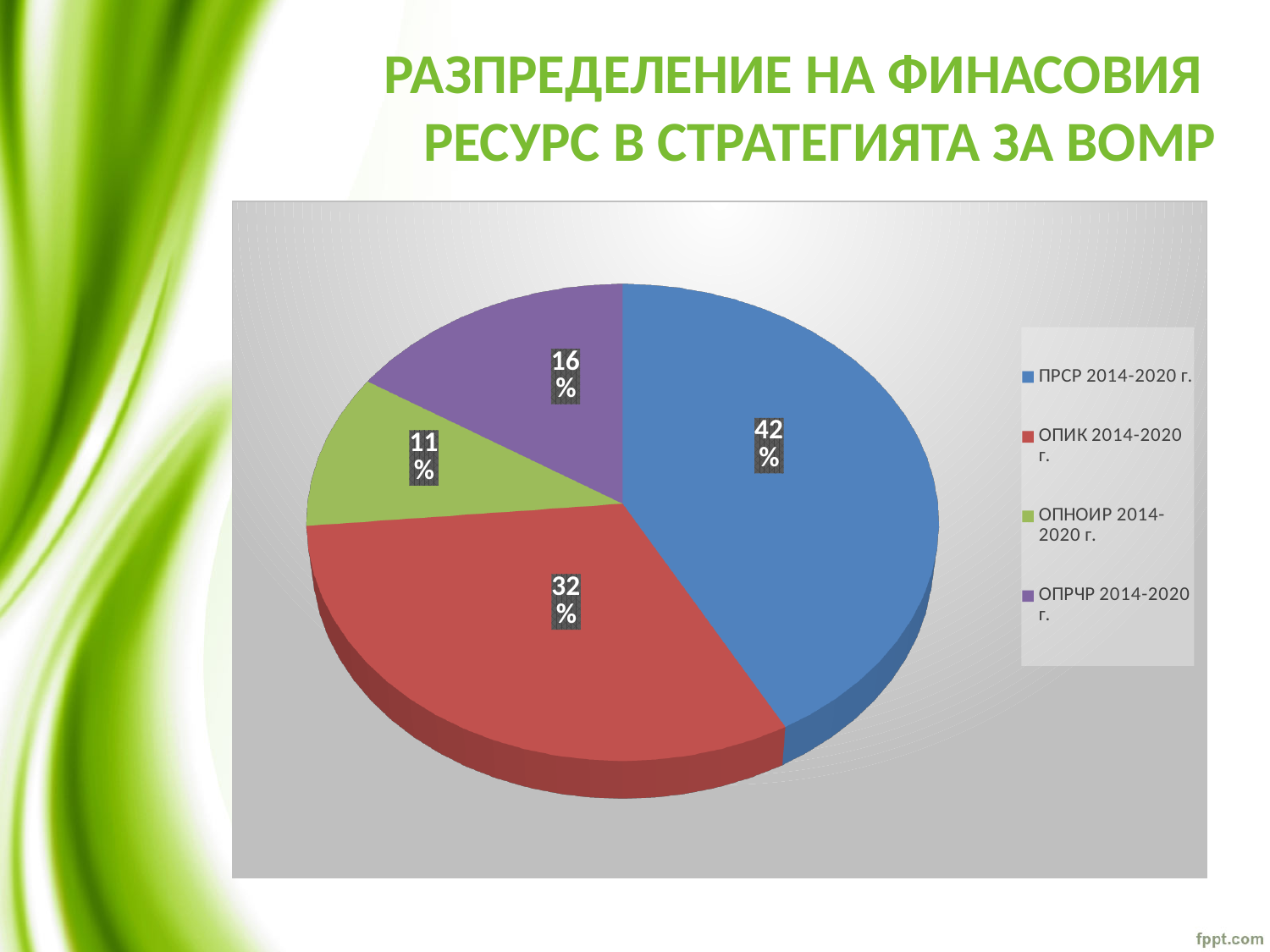
Which category has the smallest slice of the pie? ОПНОИР 2014-2020 г. What share of the pie does ОПРЧР 2014-2020 г. have? 16% What share of the pie does ОПИК 2014-2020 г. have? 32% What kind of chart is shown on the slide? Pie chart How many categories does the pie chart show? 4 What is the difference in percentage points between ПРСР 2014-2020 г. and ОПИК 2014-2020 г.? 10 Which category has the largest slice of the pie? ПРСР 2014-2020 г. Which colour represents ОПИК 2014-2020 г. in the chart? Red What is the difference in percentage points between ОПРЧР 2014-2020 г. and ОПНОИР 2014-2020 г.? 5 Which is larger, the share for ОПРЧР 2014-2020 г. or the share for ОПНОИР 2014-2020 г.? ОПРЧР 2014-2020 г. What share of the pie does ПРСР 2014-2020 г. have? 42%